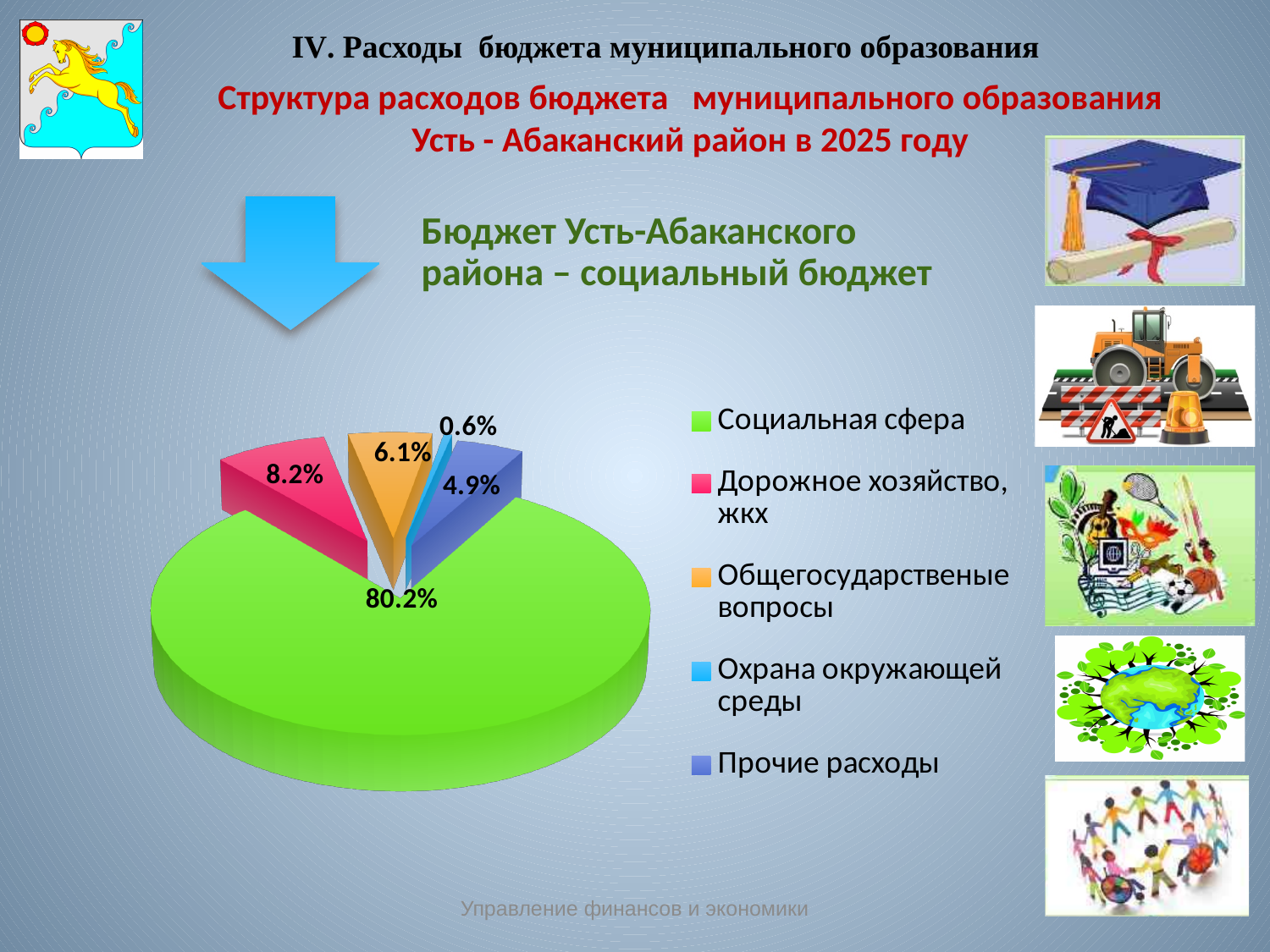
Which category has the largest slice of the pie chart? Социальная сфера What is the difference between the shares of Дорожное хозяйство, жкх and Прочие расходы? 3.3% What share of the pie chart is labelled for Социальная сфера? 80.2% What value is shown for Охрана окружающей среды in the pie chart? 0.6% What type of chart is shown on the slide? Pie chart Which category has the smallest slice of the pie chart? Охрана окружающей среды What colour is the slice for Социальная сфера in the pie chart? Green What value is shown for Дорожное хозяйство, жкх in the pie chart? 8.2% How many categories does the pie chart show? 5 Which is larger: the share of Общегосударственые вопросы or the share of Прочие расходы? Общегосударственые вопросы What value is shown for Общегосударственые вопросы in the pie chart? 6.1% What value is shown for Прочие расходы in the pie chart? 4.9%